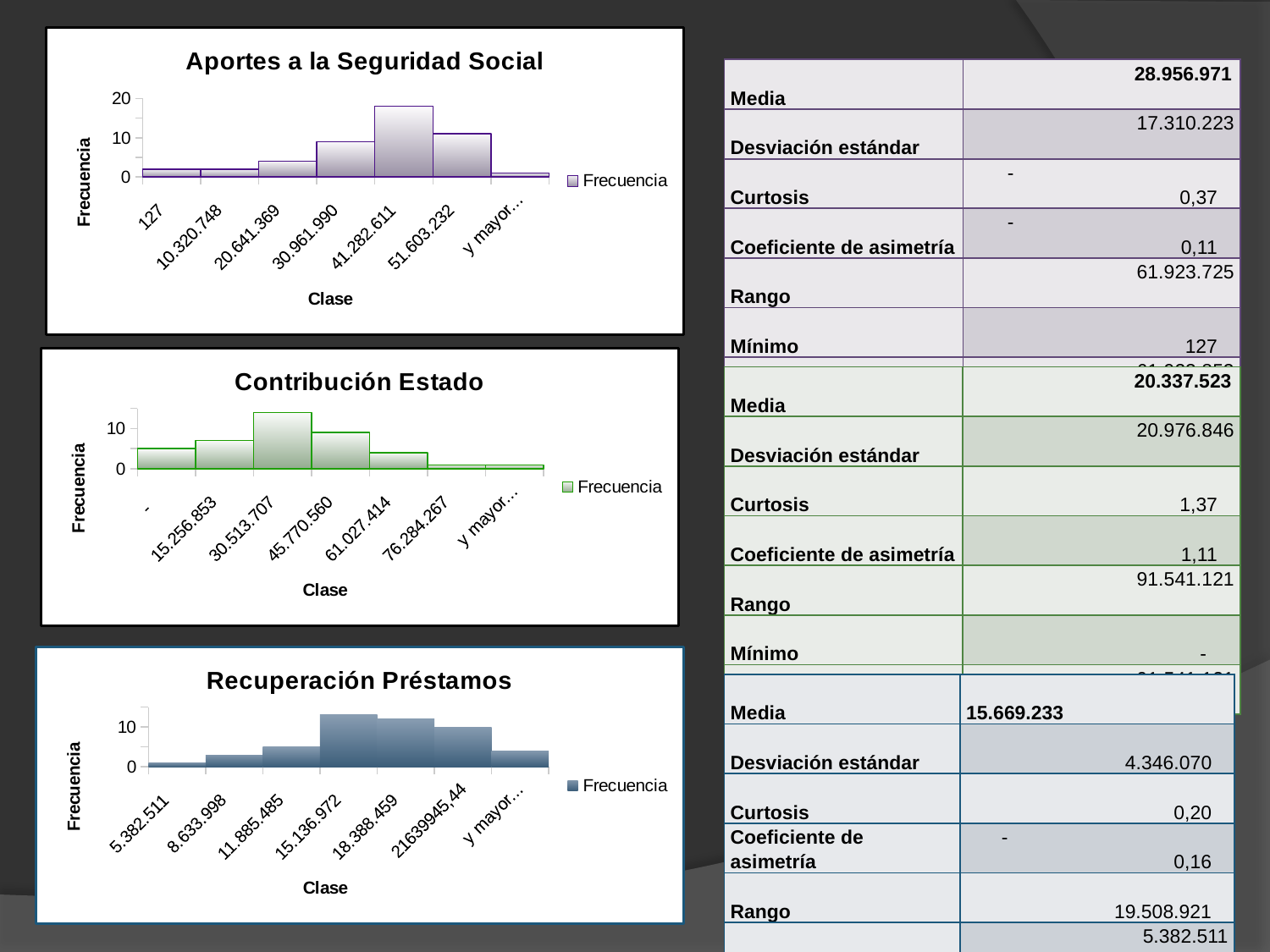
In the 'Aportes a la Seguridad Social' chart, which class has the highest frequency? 41.282.611 In the 'Recuperación Préstamos' chart, is the frequency for class 15.136.972 greater or less than 10? greater In the 'Contribución Estado' chart, is the frequency for class 61.027.414 greater or less than 10? less In the 'Aportes a la Seguridad Social' chart, is the frequency for class 41.282.611 greater or less than 10? greater In the 'Recuperación Préstamos' chart, which class has the lowest frequency? 5.382.511 How many series does the legend of the 'Recuperación Préstamos' chart list? 1 In the 'Contribución Estado' chart, which class has the highest frequency? 30.513.707 In the 'Contribución Estado' chart, which class has the larger frequency, 15.256.853 or 61.027.414? 15.256.853 What kind of chart is the 'Aportes a la Seguridad Social' chart? bar chart In the 'Aportes a la Seguridad Social' chart, which class has the larger frequency, 41.282.611 or 20.641.369? 41.282.611 How many classes are shown on the x axis of the 'Contribución Estado' chart? 7